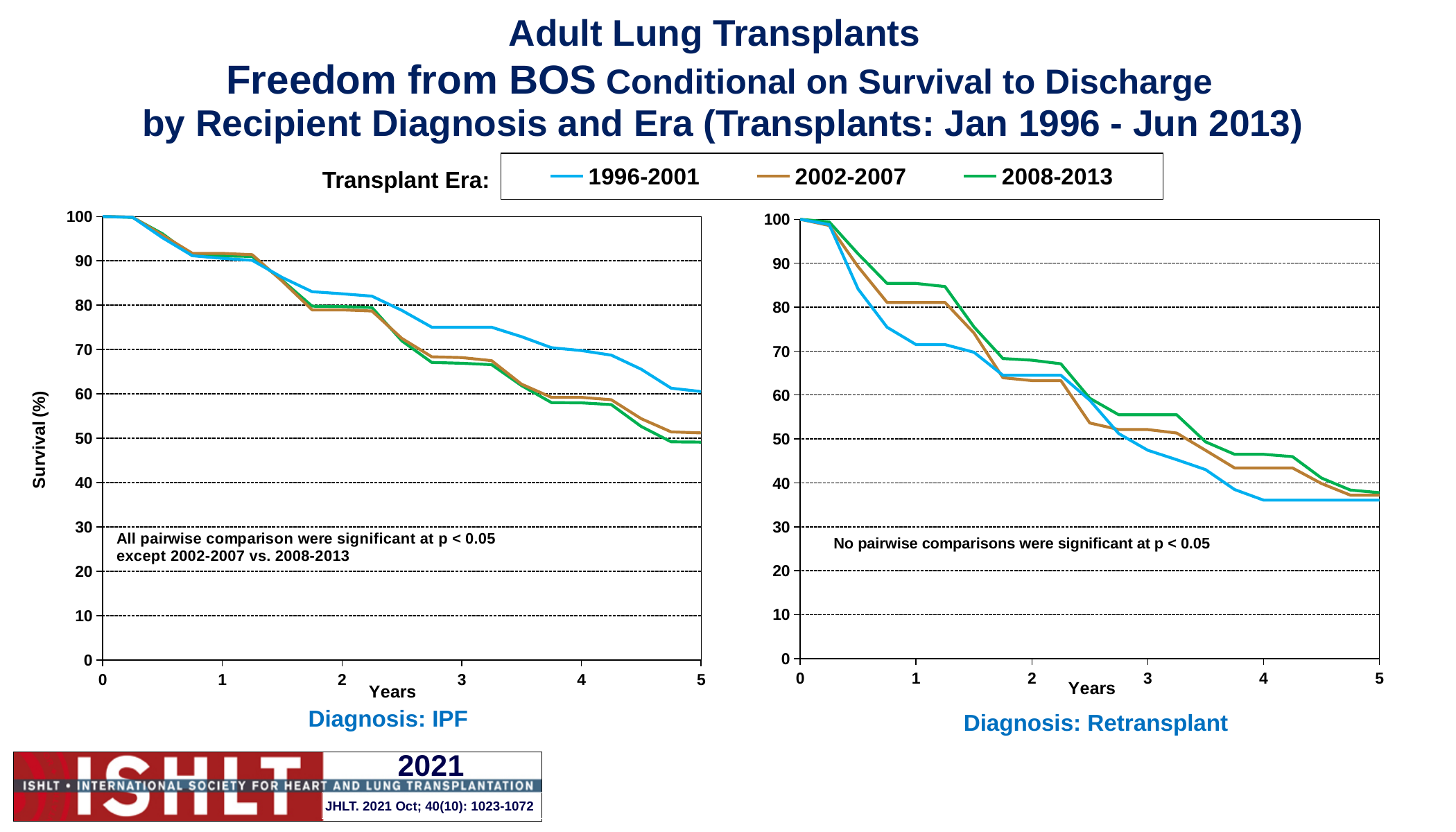
What is the label of the y axis on the Diagnosis: IPF chart? Survival (%) In the Diagnosis: IPF chart, is the value for the 1996-2001 era at year 2 greater or less than 80? greater In the Diagnosis: IPF chart, at year 3, which era has the larger value: 1996-2001 or 2008-2013? 1996-2001 In the Diagnosis: IPF chart, what is the survival value for the 1996-2001 era at year 0? 100 How many transplant eras does the legend list? 3 In the Diagnosis: Retransplant chart, is the value for the 1996-2001 era at year 3 greater or less than 50? less What kind of chart is the Diagnosis: IPF chart? line chart In the Diagnosis: Retransplant chart, is the value for the 2008-2013 era at year 1 greater or less than 80? greater In the Diagnosis: IPF chart, which era has the highest survival at year 5? 1996-2001 In the Diagnosis: Retransplant chart, at year 1, which era has the larger value: 1996-2001 or 2008-2013? 2008-2013 In the Diagnosis: IPF chart, do the survival values rise or fall as years increase? fall